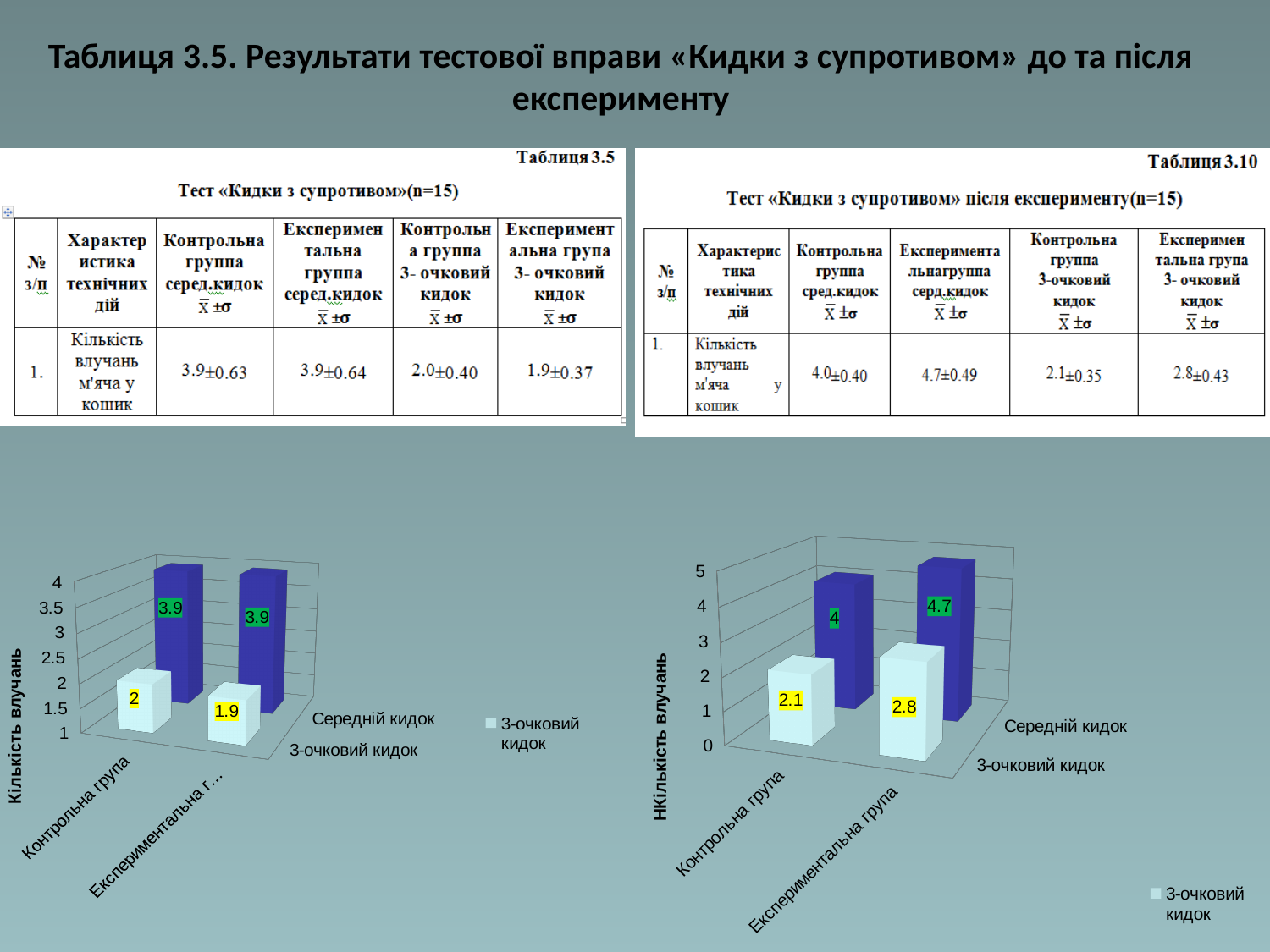
What type of chart is the left chart? 3D bar chart In the right chart, is the value of Середній кидок for Контрольна група greater or less than 3? greater How many groups are shown on the category axis of the right chart? 2 In the left chart, what is the value of 3-очковий кидок for Контрольна група? 2 In the right chart, what is the value of Середній кидок for Експериментальна група? 4.7 In the left chart, which is larger: 3-очковий кидок for Контрольна група or for Експериментальна група? Контрольна група In the right chart, what is the value of 3-очковий кидок for Контрольна група? 2.1 In the right chart, what is the difference between the 3-очковий кидок values of Експериментальна група and Контрольна група? 0.7 In the right chart, which group has the higher value for Середній кидок? Експериментальна група In the right chart, what is the difference between the Середній кидок values of Експериментальна група and Контрольна група? 0.7 In the left chart, what is the value of Середній кидок for Контрольна група? 3.9 What is the y-axis title of the left chart? Кількість влучань